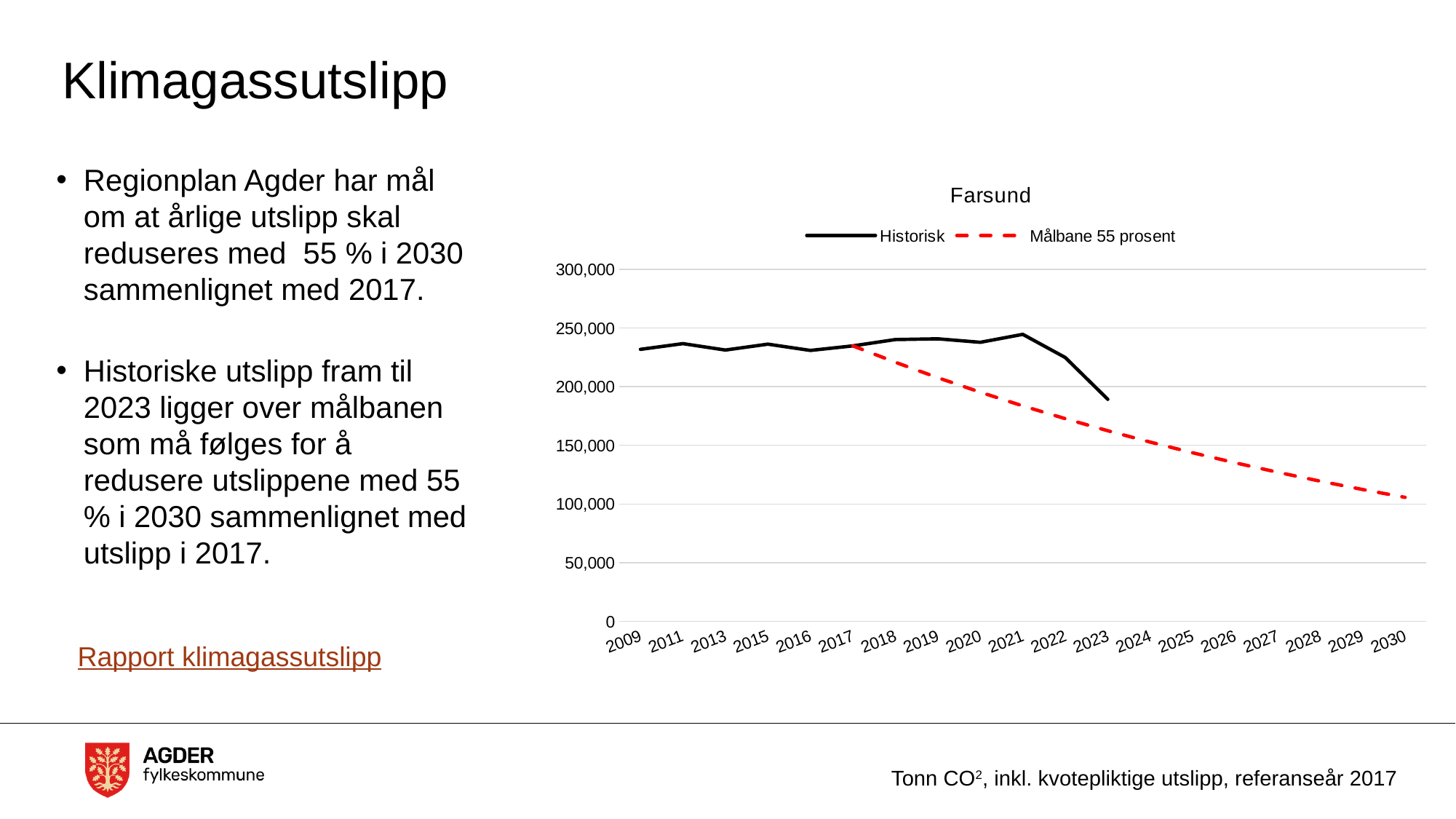
Is the Historisk value for 2023 greater or less than 200,000? less Is the Målbane 55 prosent value for 2027 greater or less than 150,000? less Does the Målbane 55 prosent series rise or fall from 2017 to 2030? Fall What is the title of the chart? Farsund In which year is the Historisk series at its lowest? 2023 What kind of chart is shown on the slide? Line chart Is the Historisk value for 2009 greater or less than 200,000? greater How many series does the chart legend list? 2 How many year labels are shown on the x axis? 19 Which series is drawn as a red dashed line? Målbane 55 prosent Which is larger in 2022, the Historisk value or the Målbane 55 prosent value? Historisk